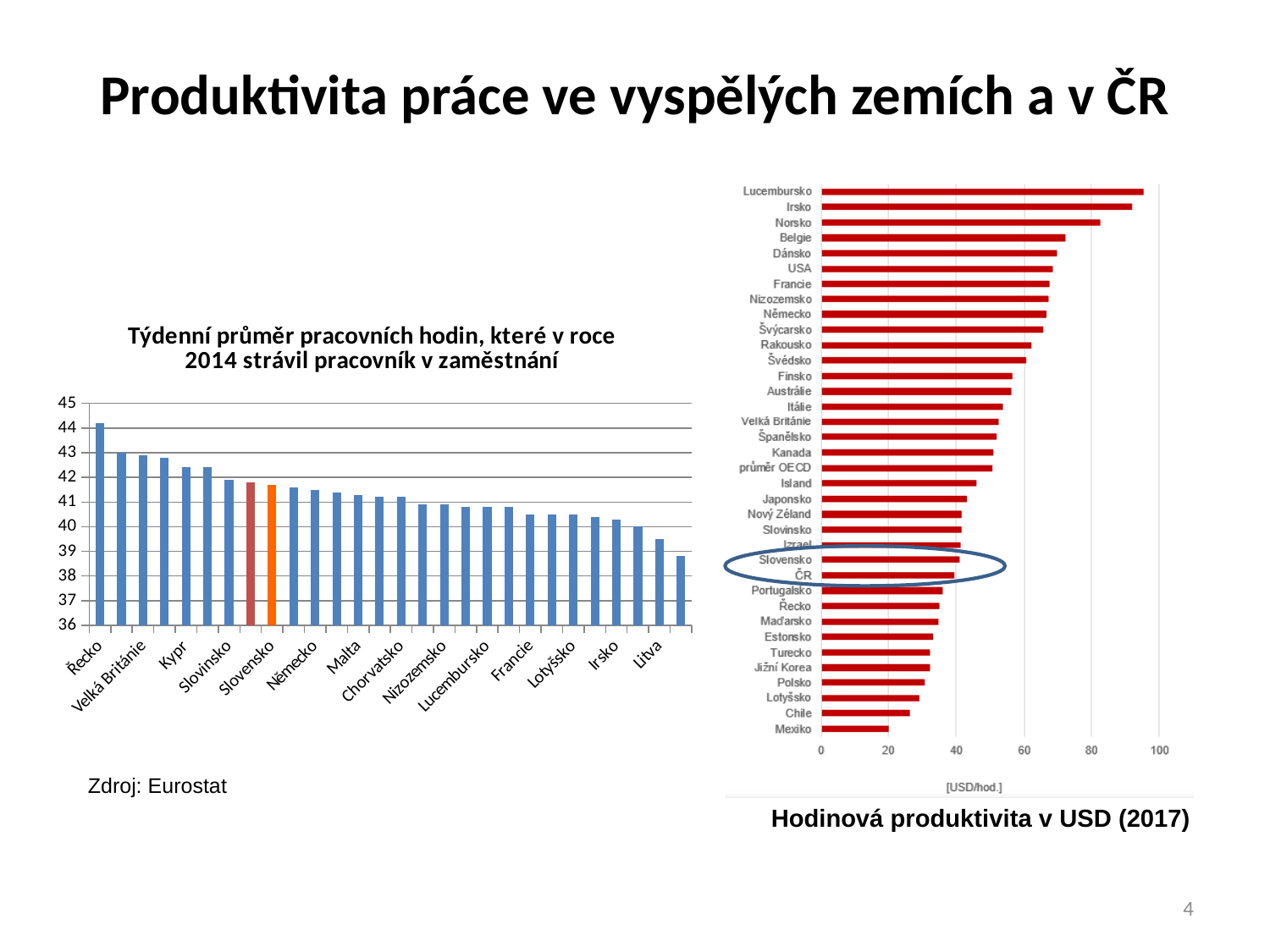
In the chart "Hodinová produktivita v USD (2017)", which country has the lowest value? Mexiko How many countries (including průměr OECD) are listed in the chart "Hodinová produktivita v USD (2017)"? 36 In the chart "Hodinová produktivita v USD (2017)", is the value for Lucembursko greater or less than 80? greater In the left chart "Týdenní průměr pracovních hodin, které v roce 2014 strávil pracovník v zaměstnání", do the values rise or fall from left to right? fall In the chart "Hodinová produktivita v USD (2017)", is the value for Japonsko greater or less than 60? less In the left chart "Týdenní průměr pracovních hodin, které v roce 2014 strávil pracovník v zaměstnání", is the value for Litva greater or less than 40? less In the chart "Hodinová produktivita v USD (2017)", which country has the highest value? Lucembursko What kind of chart is the chart titled "Hodinová produktivita v USD (2017)" on the right of the slide? bar chart In the chart "Hodinová produktivita v USD (2017)", which two countries are circled? Slovensko and ČR In the left chart "Týdenní průměr pracovních hodin, které v roce 2014 strávil pracovník v zaměstnání", which country has the highest value? Řecko In the chart "Hodinová produktivita v USD (2017)", which has the larger value, Německo or Polsko? Německo